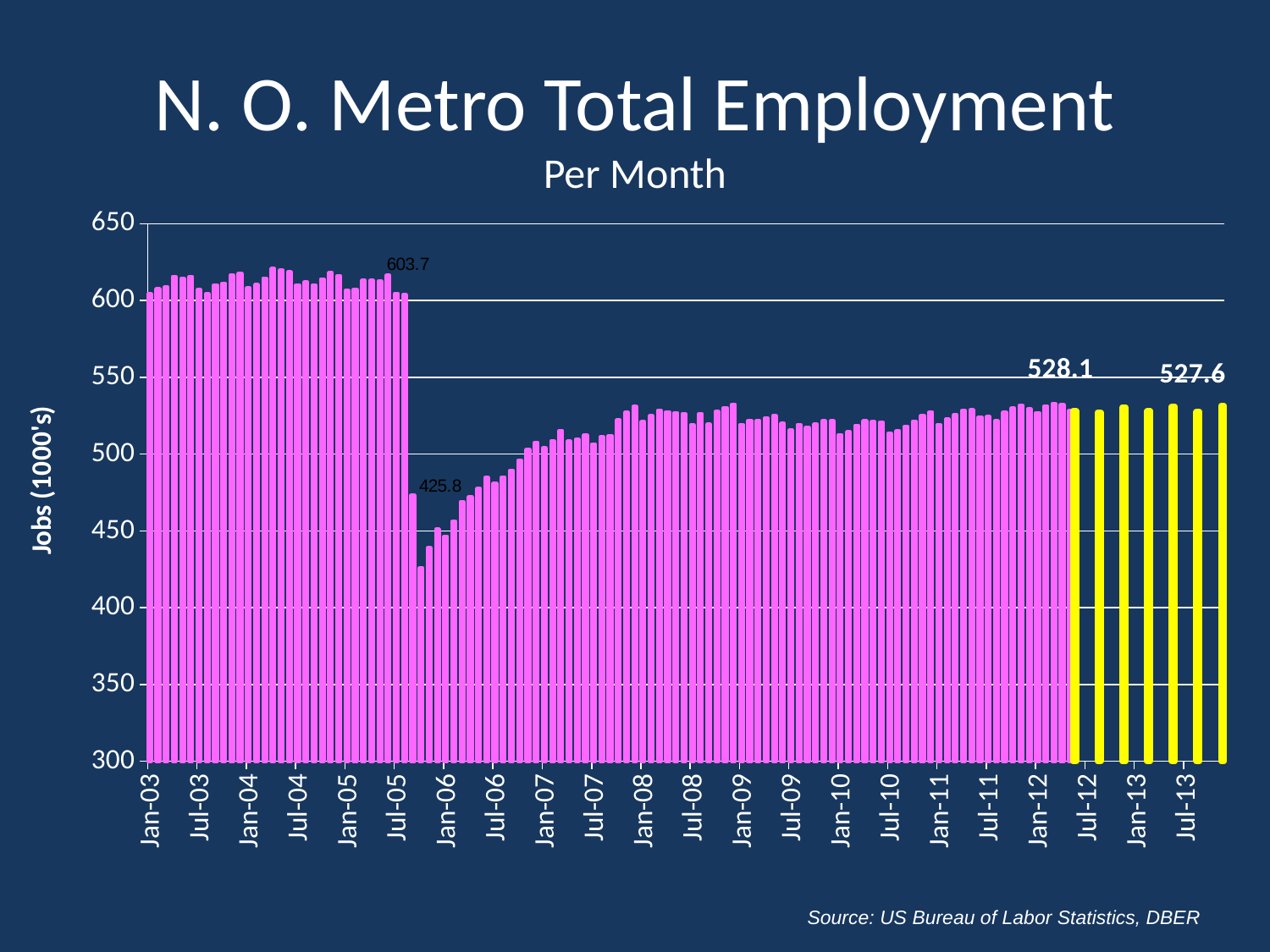
What is the title of the chart? N. O. Metro Total Employment Is the value for Jul-06 greater or less than 500? less What is the difference between the labeled values 528.1 and 527.6? 0.5 What value is printed above the lowest bar in the chart? 425.8 Do the values rise or fall from Jan-06 to Jan-08? rise Which is larger, the value for Jan-04 or the value for Jan-08? Jan-04 What value is printed above the last magenta bars, just before the yellow bars begin? 528.1 What kind of chart is shown on the slide? bar chart What value is printed above the last yellow bar on the right? 527.6 What is the difference between the labeled values 603.7 and 425.8? 177.9 What is the label on the vertical axis? Jobs (1000's) What value is printed above the bar just before the sharp drop in late 2005? 603.7